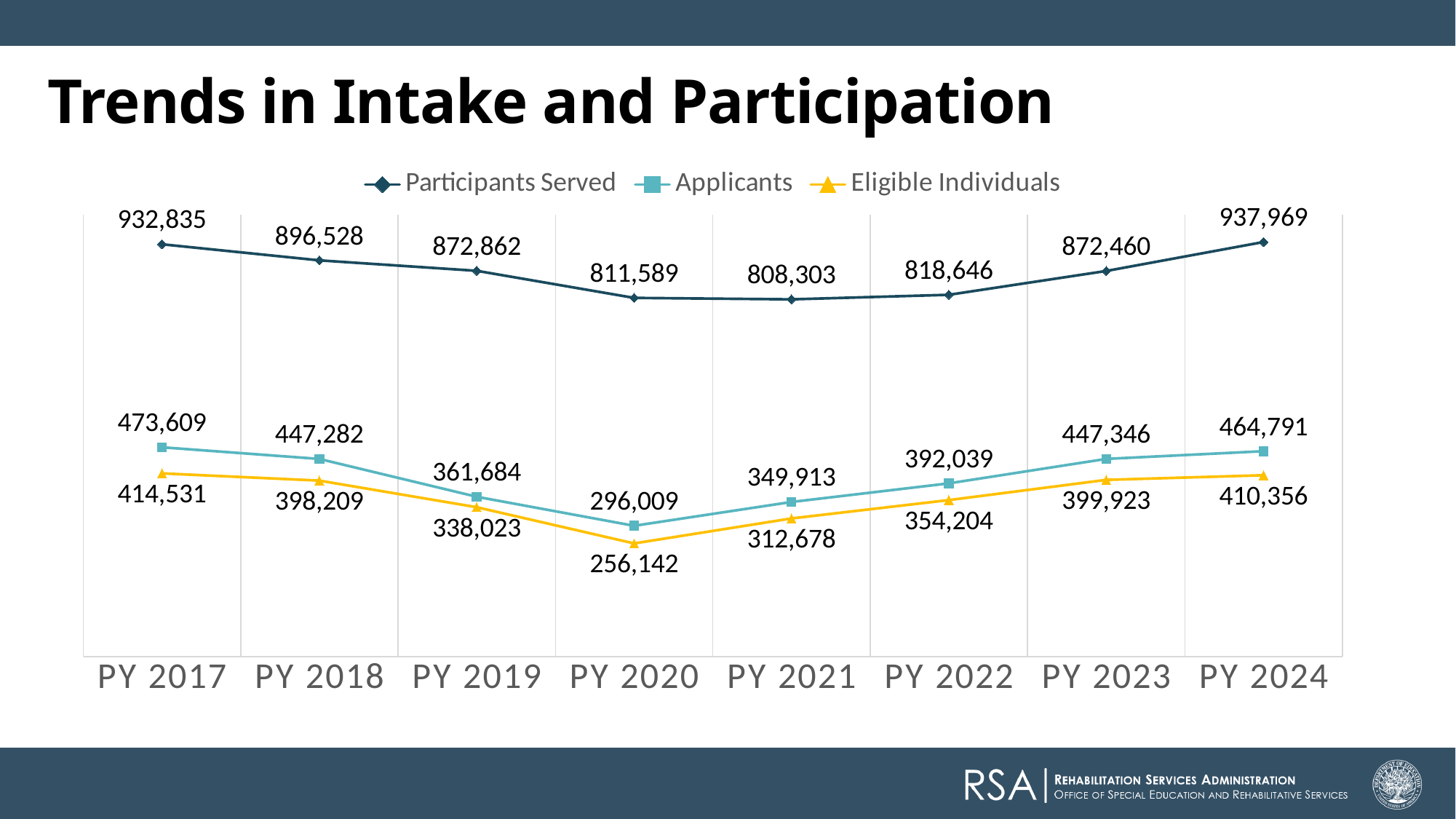
In which program year was the number of Participants Served lowest? PY 2021 How many Applicants were there in PY 2023? 447,346 What is the value for Eligible Individuals in PY 2021? 312,678 In which program year was the number of Eligible Individuals lowest? PY 2020 What is the difference between Applicants in PY 2017 and Applicants in PY 2020? 177,600 By how much did Participants Served in PY 2024 exceed Participants Served in PY 2017? 5,134 How many series does the legend list? 3 Does the number of Applicants rise or fall from PY 2020 to PY 2024? rise What is the value for Participants Served in PY 2020? 811,589 How many program years are shown on the x axis? 8 In which program year was the number of Applicants highest? PY 2017 Which is larger: Applicants in PY 2018 or Applicants in PY 2023? Applicants in PY 2023